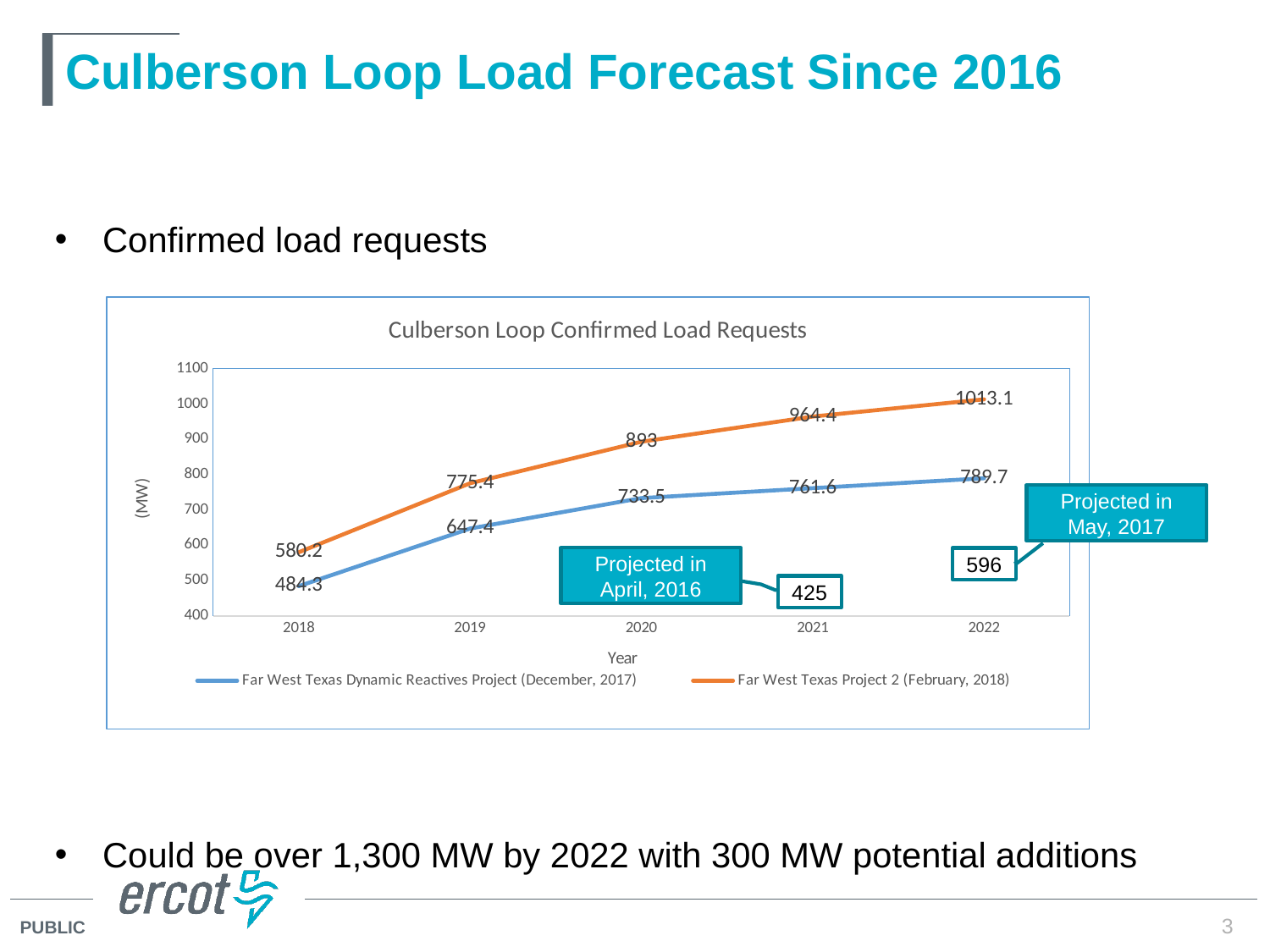
What is the value for Far West Texas Project 2 (February, 2018) in 2022? 1013.1 Which series has the larger value in 2019? Far West Texas Project 2 (February, 2018) How many years are plotted along the x axis? 5 What is the value for Far West Texas Project 2 (February, 2018) in 2020? 893 What is the value for Far West Texas Dynamic Reactives Project (December, 2017) in 2018? 484.3 What type of chart is shown on the slide? line chart What is the title of the chart? Culberson Loop Confirmed Load Requests Do the values of the Far West Texas Dynamic Reactives Project (December, 2017) series rise or fall from 2018 to 2022? rise What is the difference between the two series' values in 2021? 202.8 In which year is the Far West Texas Project 2 (February, 2018) series highest? 2022 How many series does the chart legend list? 2 In which year is the Far West Texas Dynamic Reactives Project (December, 2017) series lowest? 2018